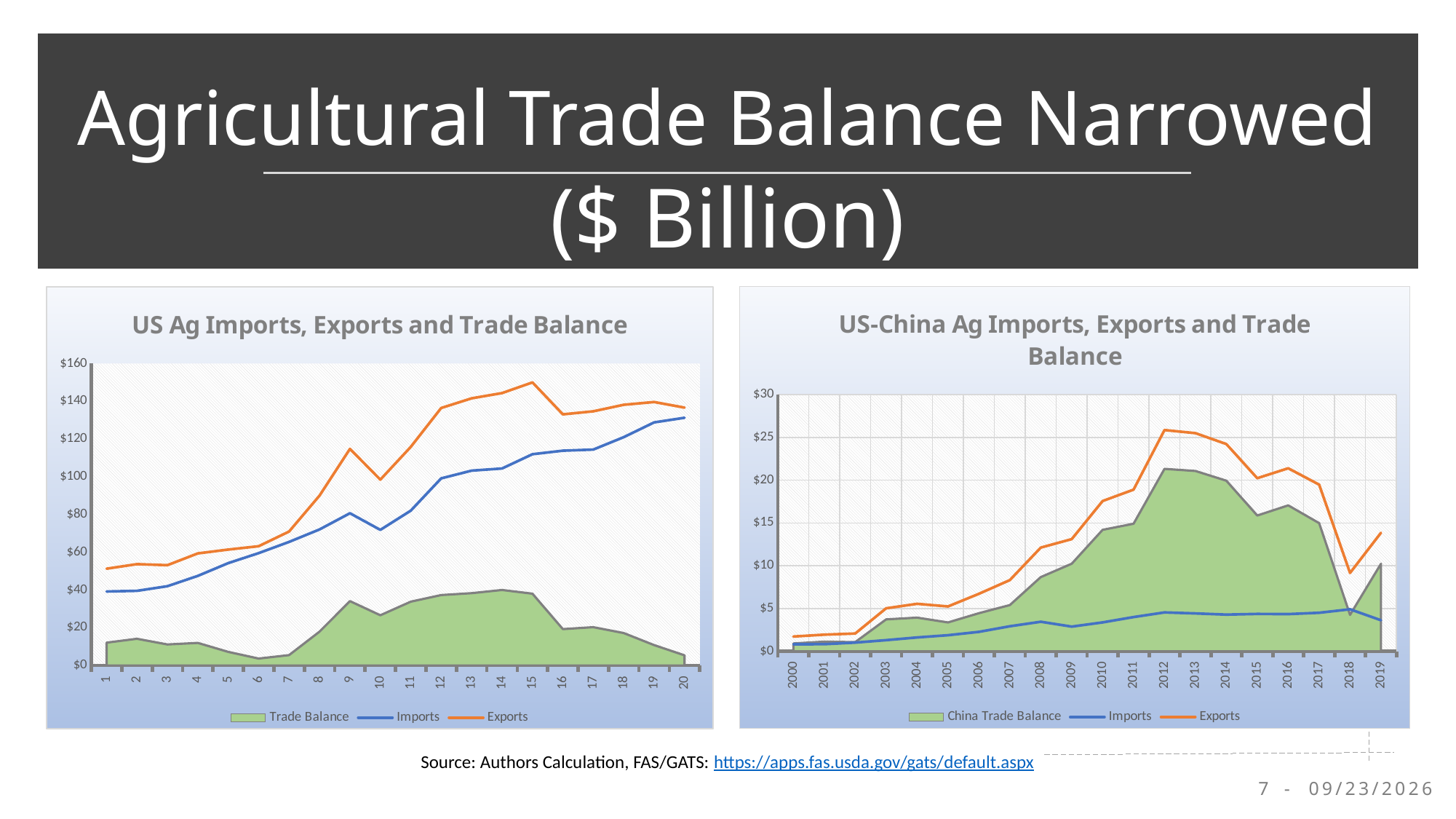
On the US-China Ag Imports, Exports and Trade Balance chart (right), do Exports rise or fall from 2012 to 2018? fall On the US-China Ag Imports, Exports and Trade Balance chart (right), in which year is the Exports value highest? 2012 On the US-China Ag Imports, Exports and Trade Balance chart (right), what are the three legend entries? China Trade Balance, Imports, Exports On the US-China Ag Imports, Exports and Trade Balance chart (right), how many years are shown on the x axis? 20 On the US Ag Imports, Exports and Trade Balance chart (left), how many points are shown on the x axis? 20 On the US Ag Imports, Exports and Trade Balance chart (left), do Imports rise or fall from point 1 to point 20? rise On the US Ag Imports, Exports and Trade Balance chart (left), how many series does the legend list? 3 On the US-China Ag Imports, Exports and Trade Balance chart (right), is the Imports value for 2019 greater or less than $5? less On the US Ag Imports, Exports and Trade Balance chart (left), is the Trade Balance value at point 6 greater or less than $20? less On the US Ag Imports, Exports and Trade Balance chart (left), at which x-axis point is the Exports value highest? 15 On the US-China Ag Imports, Exports and Trade Balance chart (right), is the China Trade Balance value for 2014 greater or less than $15? greater